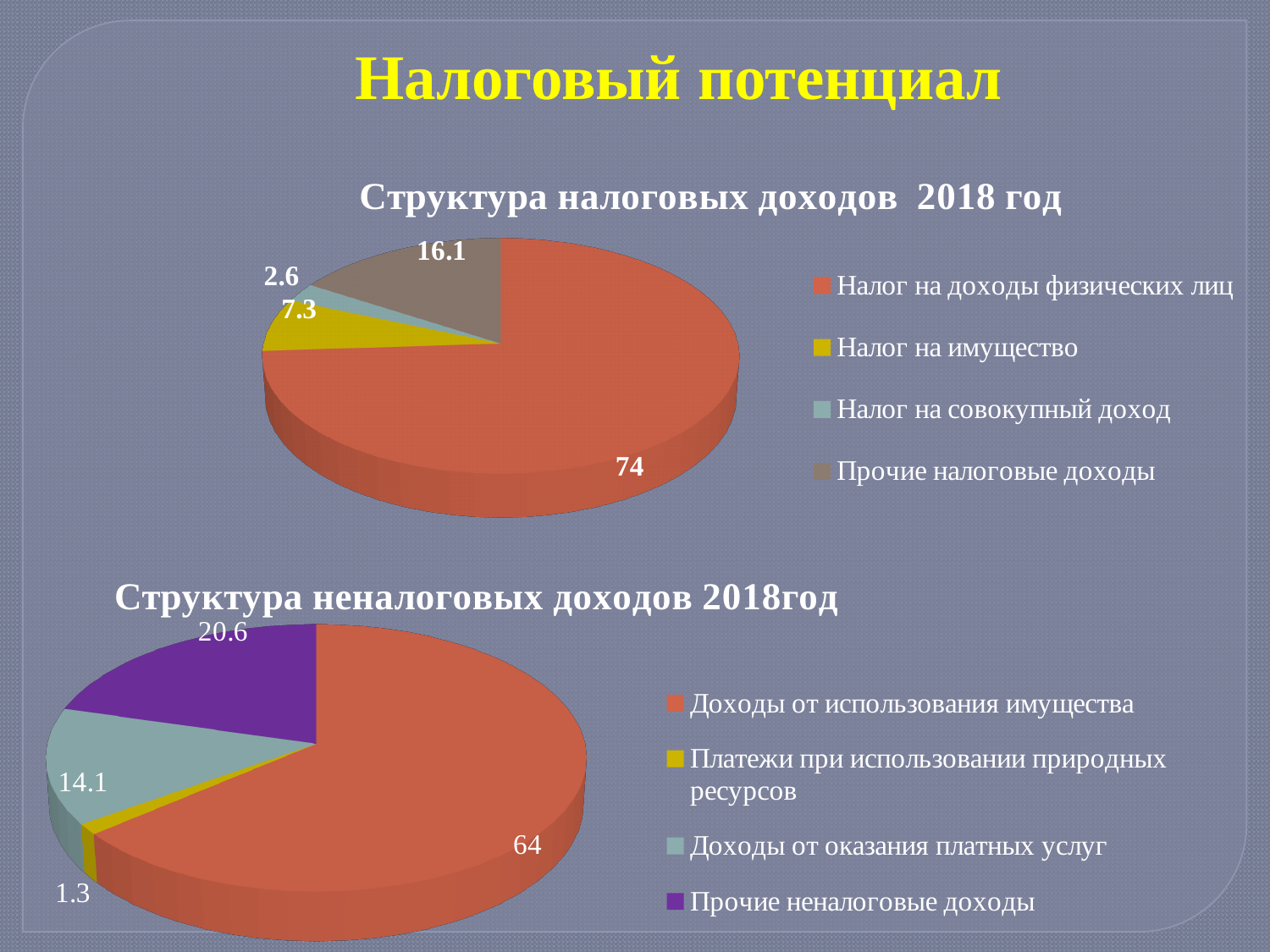
What type of chart is 'Структура налоговых доходов 2018 год'? Pie chart In the chart 'Структура неналоговых доходов 2018год', which category has the largest slice? Доходы от использования имущества In the chart 'Структура налоговых доходов 2018 год', how many categories does the legend list? 4 In the chart 'Структура налоговых доходов 2018 год', which category has the smallest slice? Налог на совокупный доход In the chart 'Структура налоговых доходов 2018 год', what is the value for 'Прочие налоговые доходы'? 16.1 In the chart 'Структура налоговых доходов 2018 год', what is the value for 'Налог на доходы физических лиц'? 74 In the chart 'Структура неналоговых доходов 2018год', what is the value for 'Доходы от оказания платных услуг'? 14.1 In the chart 'Структура неналоговых доходов 2018год', what colour is the slice for 'Прочие неналоговые доходы'? Purple In the chart 'Структура неналоговых доходов 2018год', what is the difference between the values for 'Доходы от использования имущества' and 'Прочие неналоговые доходы'? 43.4 In the chart 'Структура неналоговых доходов 2018год', what is the value for 'Платежи при использовании природных ресурсов'? 1.3 In the chart 'Структура неналоговых доходов 2018год', which is larger: 'Прочие неналоговые доходы' or 'Доходы от оказания платных услуг'? Прочие неналоговые доходы In the chart 'Структура налоговых доходов 2018 год', what is the difference between the values for 'Налог на имущество' and 'Налог на совокупный доход'? 4.7